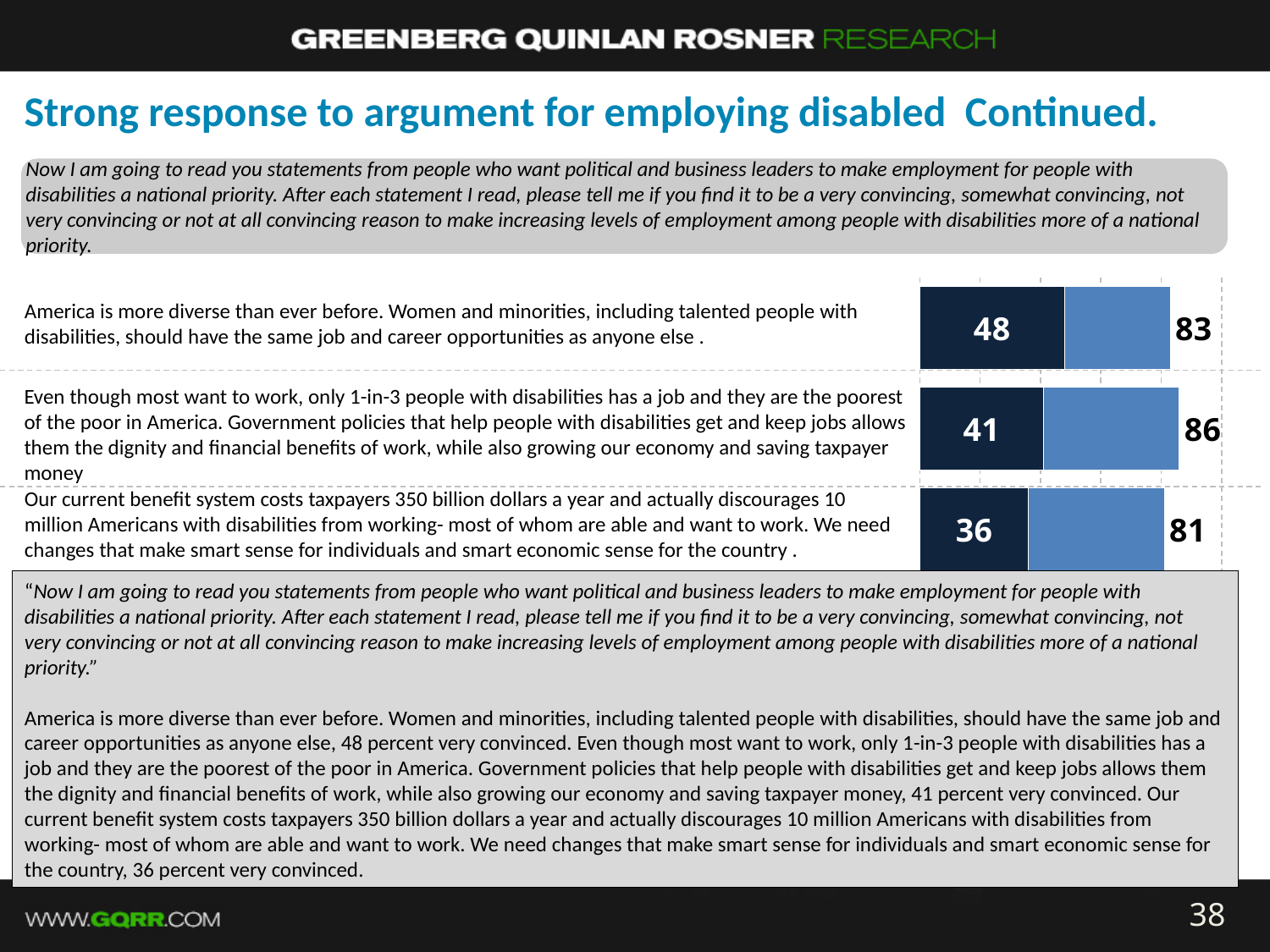
What kind of chart is shown on the slide? Stacked horizontal bar chart What is the total value shown at the end of the bar for the statement beginning 'America is more diverse than ever before'? 83 Which statement has the highest dark-segment (very convincing) value? America is more diverse than ever before What is the difference between the dark-segment values for the 'America is more diverse' statement and the 'Our current benefit system' statement? 12 Which statement has the lowest total value at the end of its bar? Our current benefit system costs taxpayers 350 billion dollars a year What is the dark-segment value for the statement beginning 'Our current benefit system costs taxpayers 350 billion dollars a year'? 36 What is the difference between the total value and the dark-segment value for the statement beginning 'America is more diverse than ever before'? 35 What is the total value shown at the end of the bar for the statement beginning 'Even though most want to work, only 1-in-3 people with disabilities has a job'? 86 Which statement has the highest total value at the end of its bar? Even though most want to work, only 1-in-3 people with disabilities has a job What is the 'very convincing' value (dark segment) for the statement beginning 'America is more diverse than ever before'? 48 How many statements (bars) are plotted in the chart? 3 Which is larger: the total value for the 'Even though most want to work' statement or the total value for the 'Our current benefit system' statement? Even though most want to work